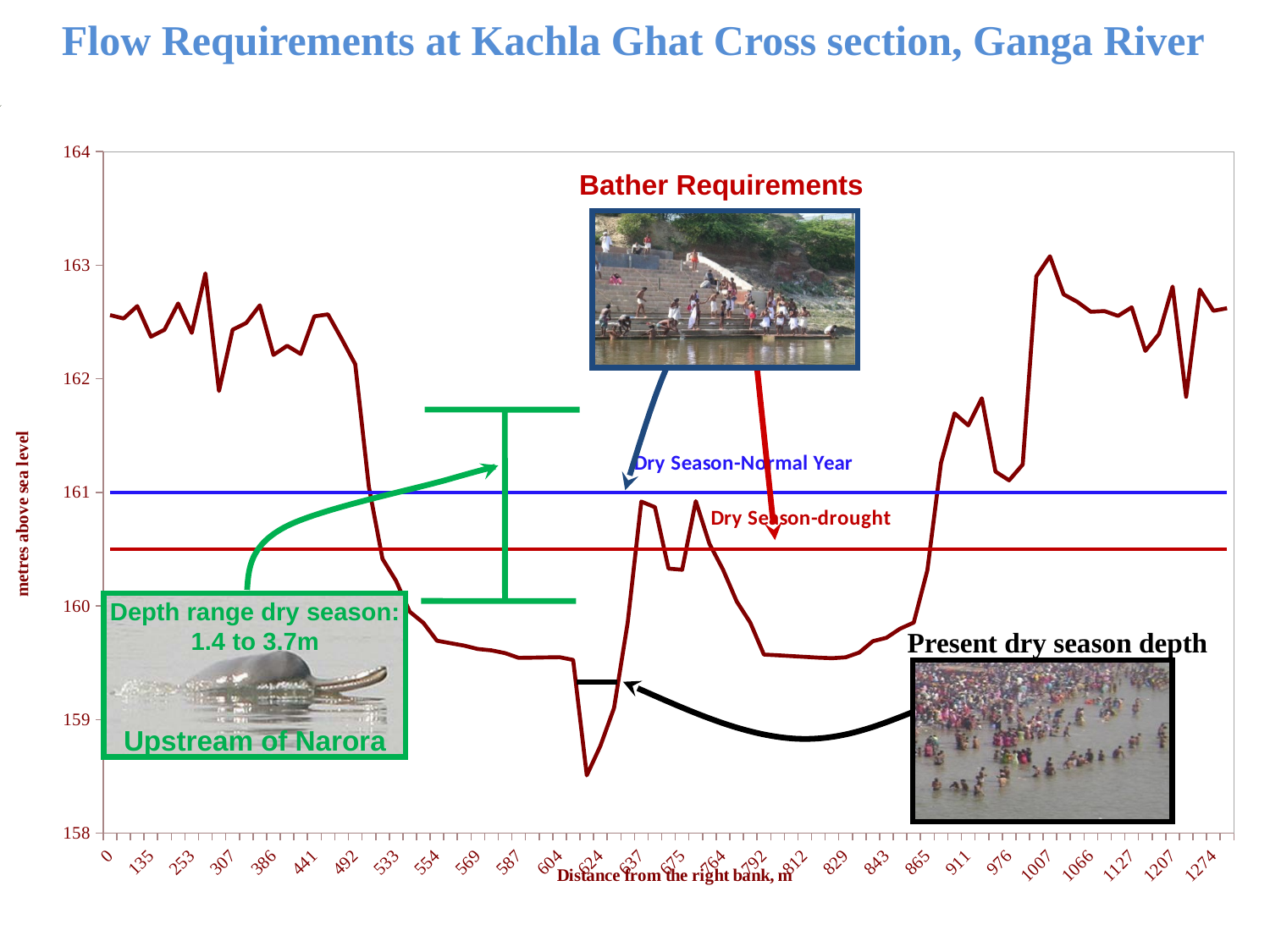
What kind of chart is shown on the slide? line chart Does the riverbed elevation rise or fall between 865 m and 1007 m from the right bank? rise Does the riverbed elevation generally rise or fall between 0 m and 624 m from the right bank? fall Which line is at a higher level, Dry Season-Normal Year or Dry Season-drought? Dry Season-Normal Year Is the Dry Season-drought line greater or less than 160 metres above sea level? greater Is the Dry Season-drought line greater or less than 161 metres above sea level? less Is the riverbed elevation at a distance of 0 m from the right bank greater or less than 162? greater At what level (metres above sea level) is the Dry Season-Normal Year line drawn? 161 What is the title of the chart on the slide? Flow Requirements at Kachla Ghat Cross section, Ganga River What is the label of the vertical axis? metres above sea level